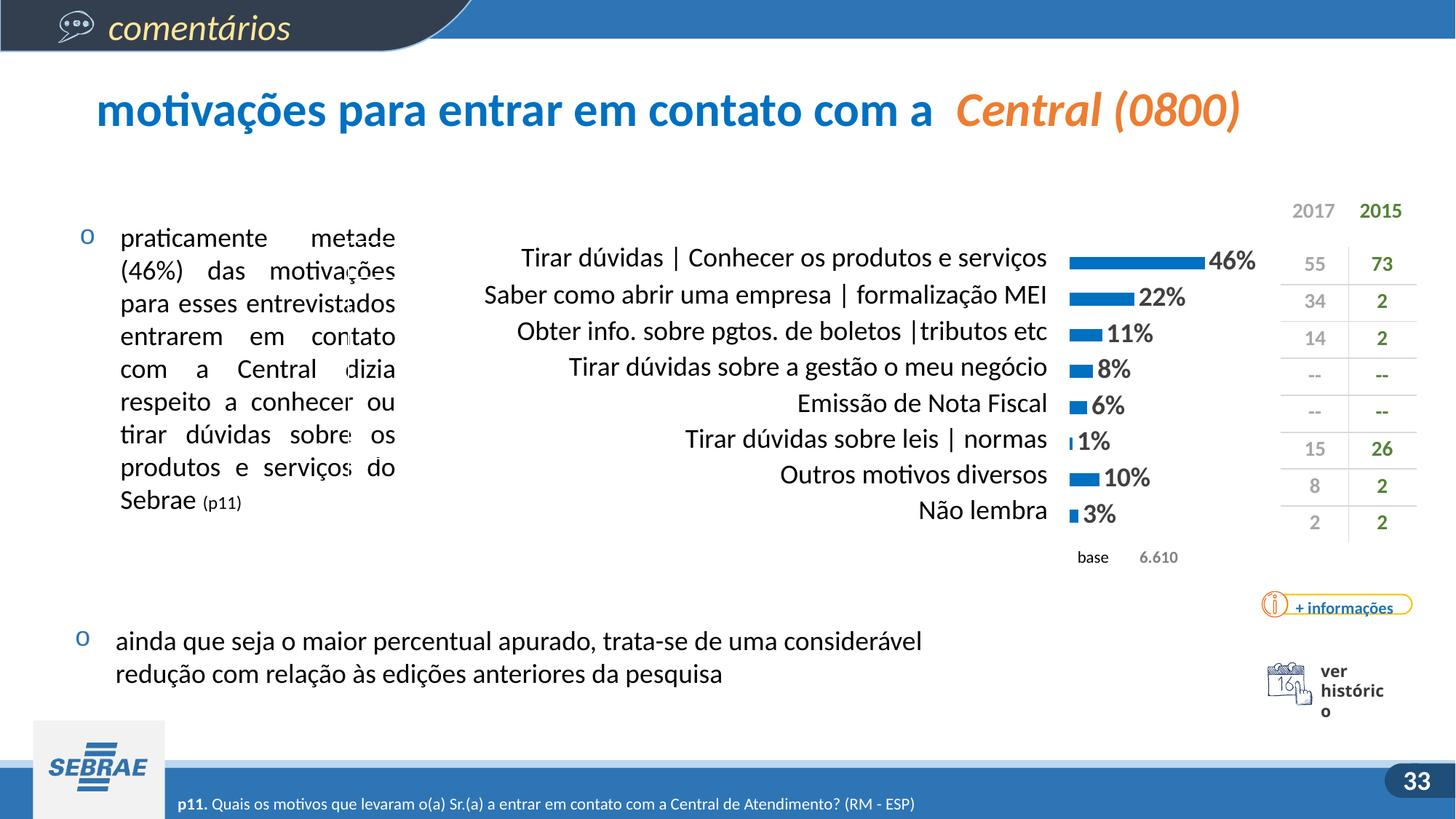
What is the value for "Saber como abrir uma empresa | formalização MEI"? 22% Which category has the lowest value? Tirar dúvidas sobre leis | normas What is the difference between the values for "Tirar dúvidas | Conhecer os produtos e serviços" and "Saber como abrir uma empresa | formalização MEI"? 24% What base (number of respondents) is shown below the chart? 6.610 Which is larger: the value for "Outros motivos diversos" or the value for "Tirar dúvidas sobre a gestão o meu negócio"? Outros motivos diversos How many categories are shown in the chart? 8 What is the value for "Não lembra"? 3% What is the difference between the values for "Obter info. sobre pgtos. de boletos |tributos etc" and "Tirar dúvidas sobre leis | normas"? 10% What kind of chart is shown on the slide? Bar chart What is the value for "Emissão de Nota Fiscal"? 6% What is the value for "Tirar dúvidas | Conhecer os produtos e serviços"? 46% Which category has the highest value? Tirar dúvidas | Conhecer os produtos e serviços